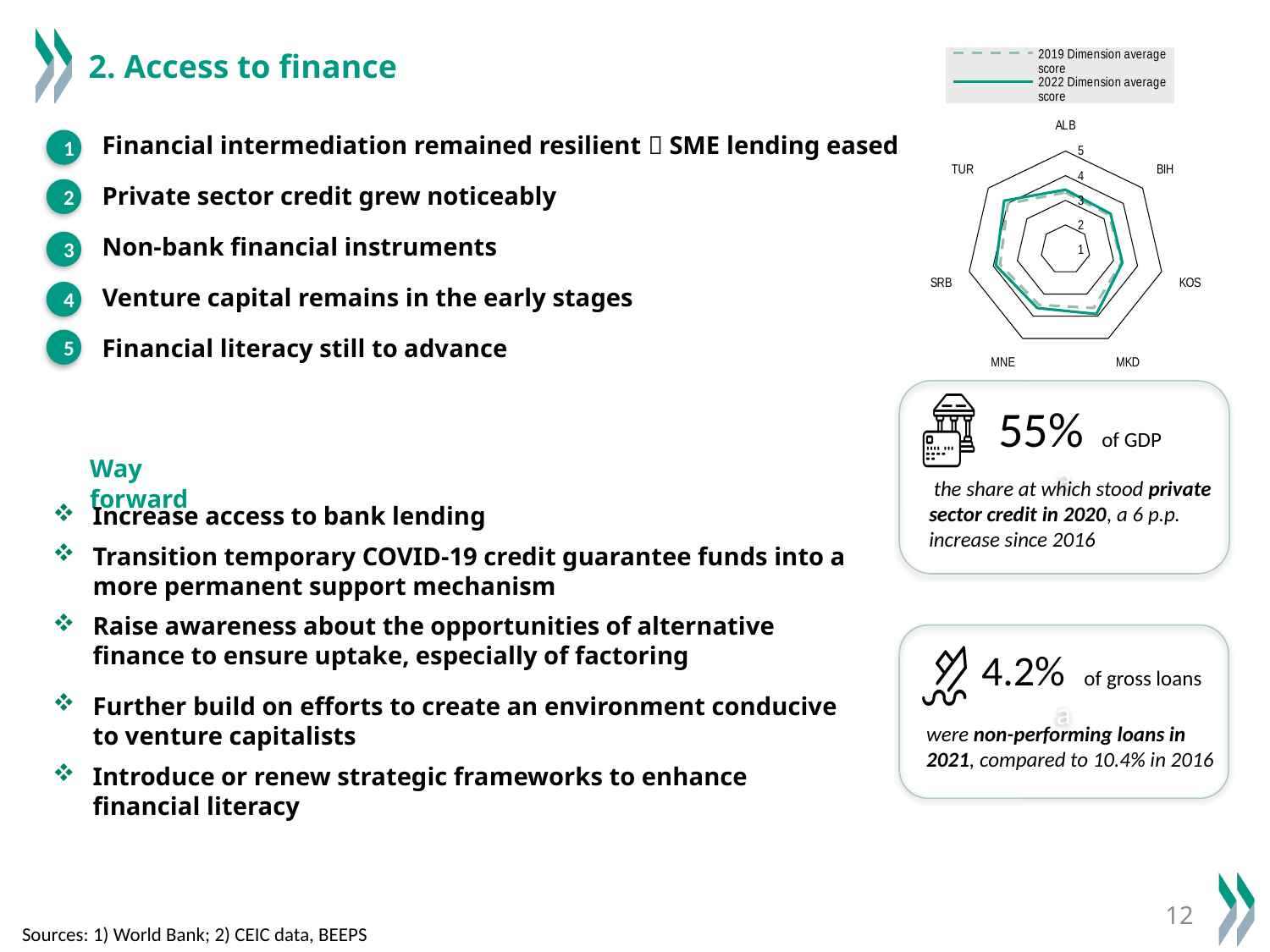
Which series in the radar chart is drawn with a dashed line? 2019 Dimension average score What kind of chart is shown on the slide? Radar chart Is the 2019 Dimension average score for SRB greater or less than 2? greater Is the 2019 Dimension average score for TUR greater or less than 1? greater Is the 2022 Dimension average score for MNE greater or less than 5? less What is the maximum value shown on the radar chart's scale? 5 Which two series are shown in the radar chart's legend? 2019 Dimension average score and 2022 Dimension average score How many economies (categories) are plotted on the radar chart? 7 How many series does the legend of the radar chart list? 2